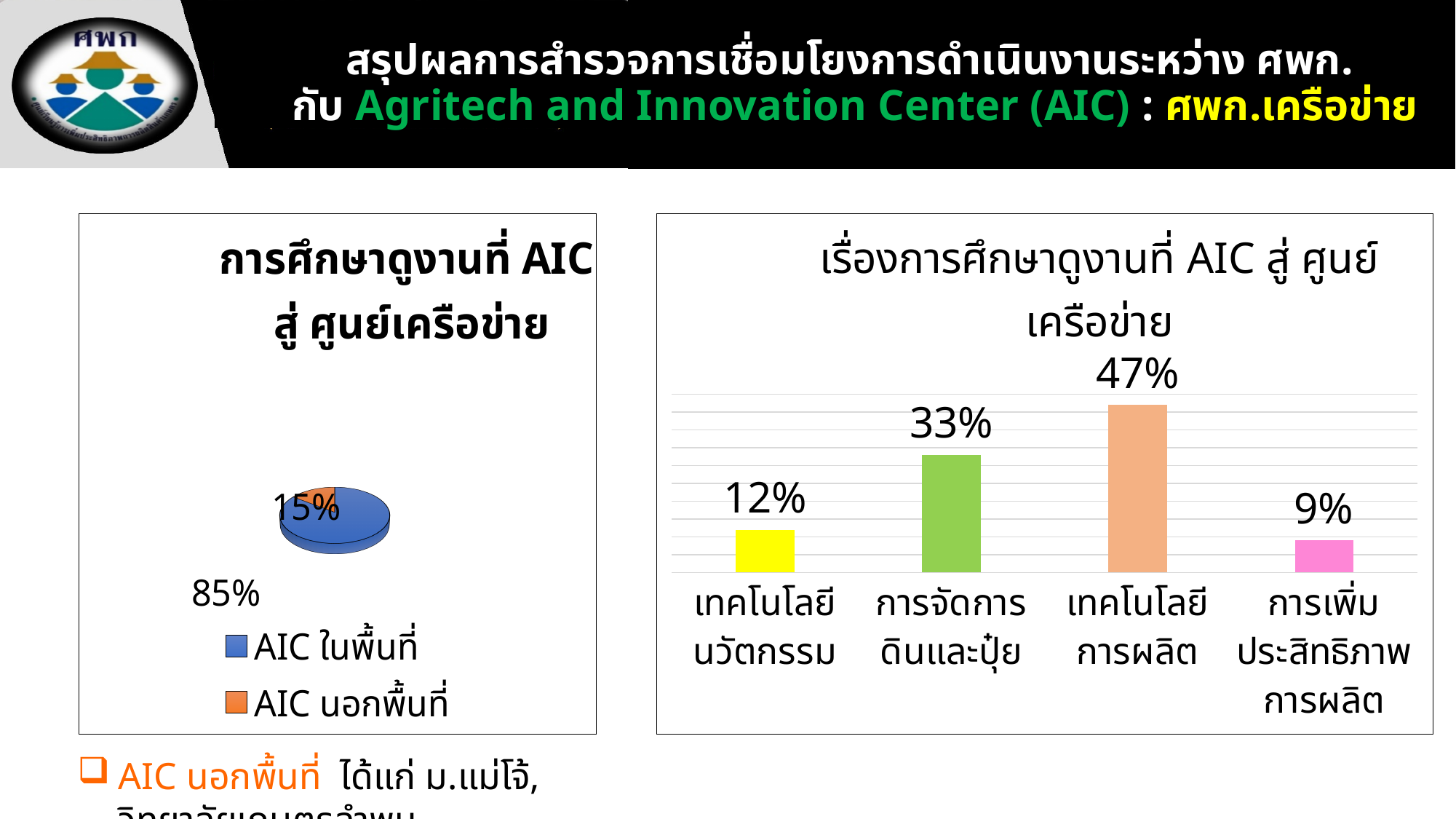
How many entries does the legend of the pie chart on the left list? 2 In the bar chart on the right, what is the value for เทคโนโลยีการผลิต? 47% In the bar chart on the right, what is the value for เทคโนโลยีนวัตกรรม? 12% In the bar chart on the right, what is the value for การจัดการดินและปุ๋ย? 33% In the bar chart on the right, which category has the lowest value? การเพิ่มประสิทธิภาพการผลิต In the pie chart on the left, what share does AIC ในพื้นที่ have? 85% In the bar chart on the right, what is the difference between the values for เทคโนโลยีการผลิต and การจัดการดินและปุ๋ย? 14% In the bar chart on the right, which category has the highest value? เทคโนโลยีการผลิต How many categories are shown in the bar chart on the right? 4 What kind of chart is the chart on the right? Bar chart In the pie chart on the left, what share does AIC นอกพื้นที่ have? 15% In the bar chart on the right, which is larger: the value for เทคโนโลยีนวัตกรรม or การเพิ่มประสิทธิภาพการผลิต? เทคโนโลยีนวัตกรรม